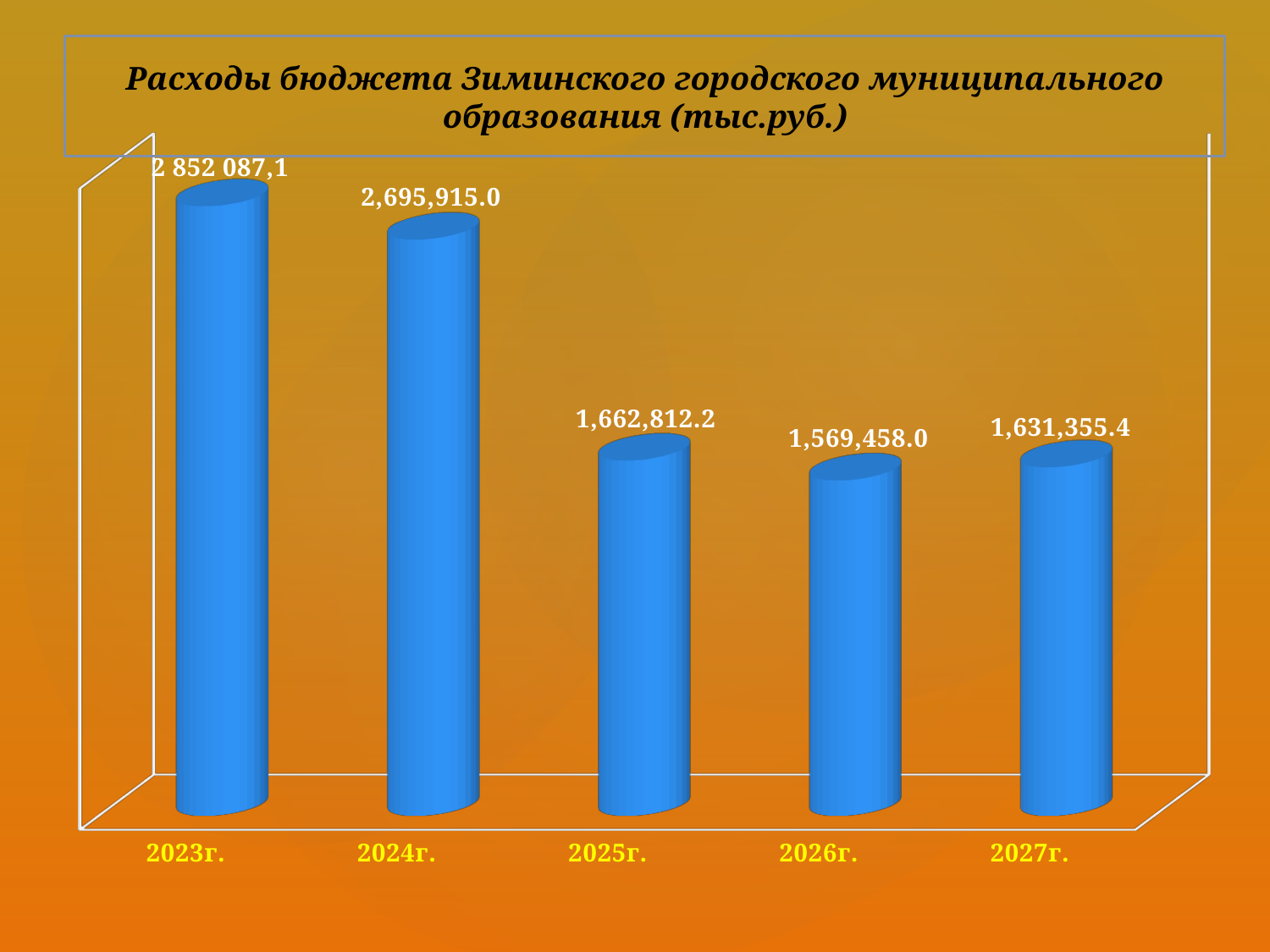
What is the value for 2027г.? 1,631,355.4 What is the value for 2024г.? 2,695,915.0 What kind of chart is this? Bar chart What is the value for 2023г.? 2 852 087,1 Which is larger, the value for 2025г. or the value for 2027г.? 2025г. What is the difference between the values for 2024г. and 2025г.? 1,033,102.8 What is the difference between the values for 2027г. and 2026г.? 61,897.4 What is the value for 2025г.? 1,662,812.2 What is the value for 2026г.? 1,569,458.0 How many years are shown on the chart? 5 Which year has the lowest value? 2026г. Which year has the highest value? 2023г.